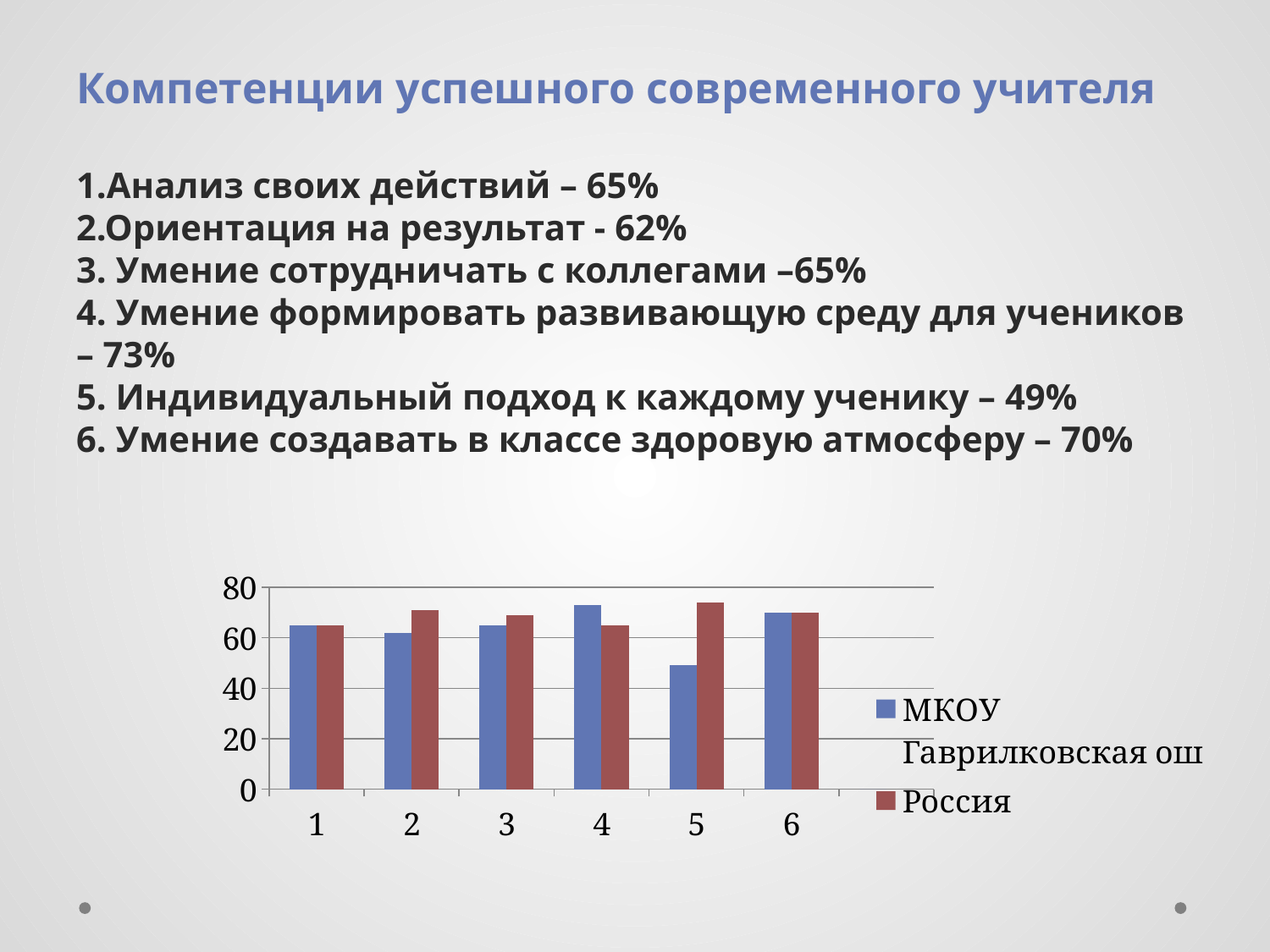
Is the value for МКОУ Гавриловская ош in category 4 greater or less than 60? greater In category 4, which series has the larger value, МКОУ Гавриловская ош or Россия? МКОУ Гавриловская ош How many categories are shown on the x axis of the chart? 6 Which category has the lowest value for the МКОУ Гавриловская ош series? 5 In category 2, which series has the larger value, МКОУ Гавриловская ош or Россия? Россия What colour are the bars for the Россия series? red How many series does the chart legend list? 2 Is the value for МКОУ Гавриловская ош in category 5 greater or less than 60? less What kind of chart is shown on the slide? bar chart Is the value for Россия in category 5 greater or less than 60? greater In category 5, which series has the larger value, МКОУ Гавриловская ош or Россия? Россия Which category has the highest value for the МКОУ Гавриловская ош series? 4